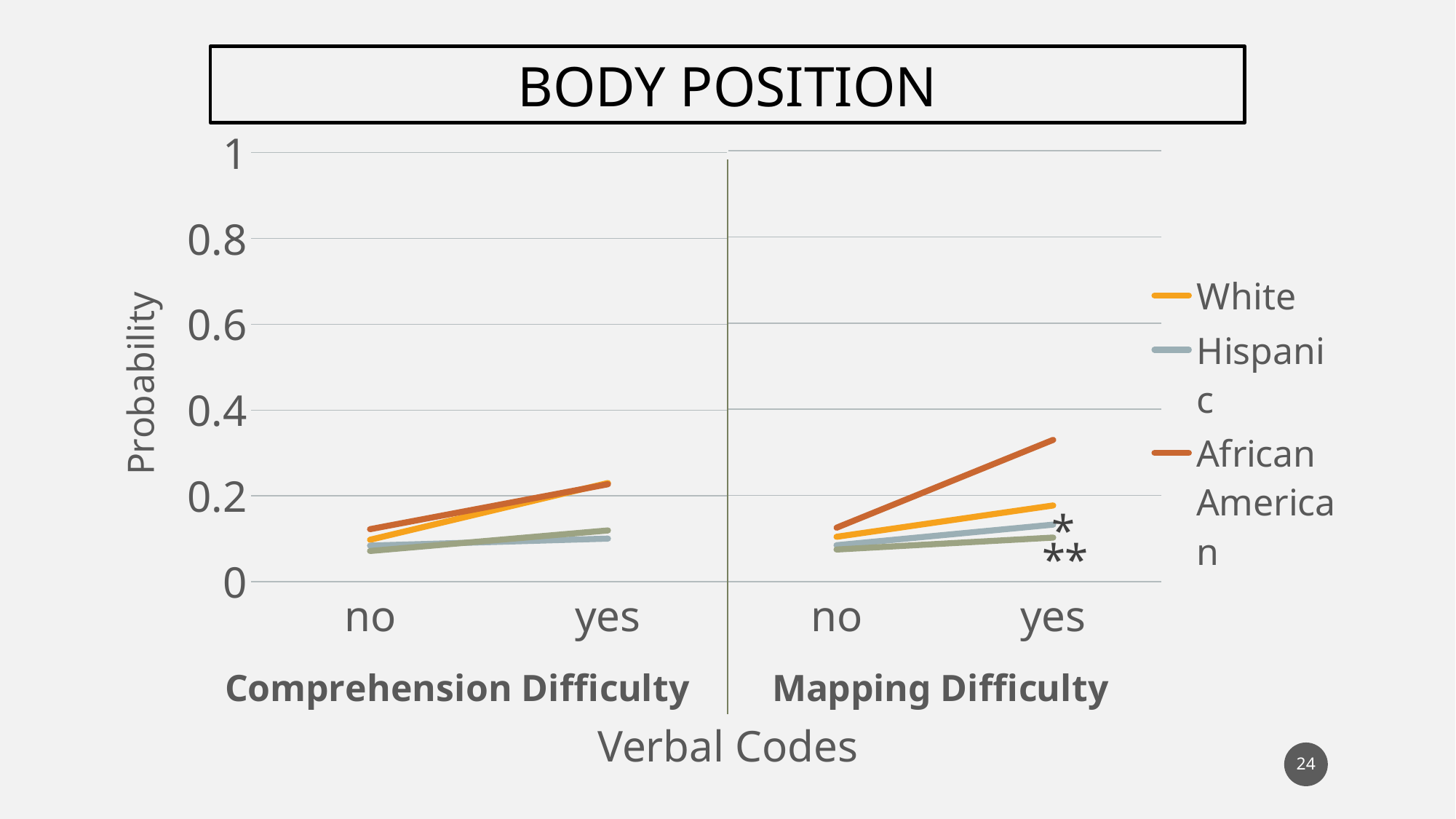
What is the label of the y axis? Probability At 'yes' under Mapping Difficulty, which is larger: the value for African American or the value for Hispanic? African American Is the value for African American at 'yes' under Mapping Difficulty greater or less than 0.4? less Is the value for African American at 'yes' under Mapping Difficulty greater or less than 0.2? greater What is the title of the chart? BODY POSITION Is the value for Hispanic at 'yes' under Mapping Difficulty greater or less than 0.2? less How many series does the legend list? 3 Does the White line rise or fall from 'no' to 'yes' under Comprehension Difficulty? rise What kind of chart is shown on the slide? line chart Which series has the highest value at 'yes' under Mapping Difficulty? African American Does the African American line rise or fall from 'no' to 'yes' under Mapping Difficulty? rise